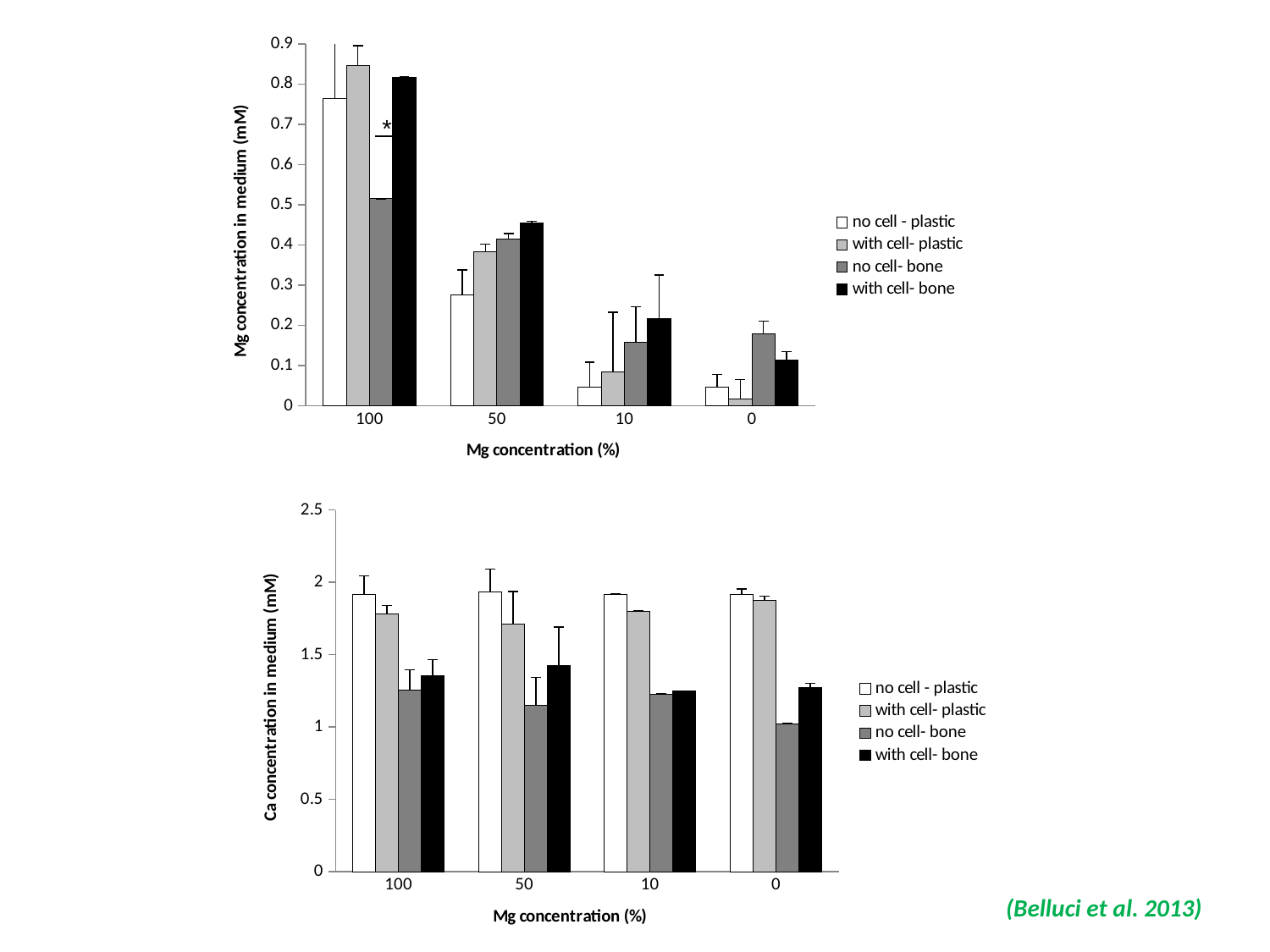
What is the y-axis label of the bottom chart? Ca concentration in medium (mM) In the bottom chart (Ca concentration in medium), at 10% Mg concentration, which is larger: 'no cell - plastic' or 'no cell- bone'? no cell - plastic In the bottom chart (Ca concentration in medium), which series has the lowest value at 0% Mg concentration? no cell- bone In the top chart (Mg concentration in medium), at 100% Mg concentration, which is larger: 'no cell- bone' or 'with cell- bone'? with cell- bone In the top chart (Mg concentration in medium), how many series does the legend list? 4 In the top chart (Mg concentration in medium), how many Mg concentration categories are shown on the x axis? 4 In the top chart (Mg concentration in medium), is the value for 'no cell- bone' at 100% Mg concentration greater or less than 0.6? less In the top chart (Mg concentration in medium), do the values for 'with cell- plastic' rise or fall moving from 100 to 0 along the x axis? fall What kind of chart is the top chart (Mg concentration in medium)? bar chart In the top chart (Mg concentration in medium), which series has the lowest value at 50% Mg concentration? no cell - plastic In the top chart (Mg concentration in medium), is the value for 'no cell - plastic' at 100% Mg concentration greater or less than 0.5? greater In the bottom chart (Ca concentration in medium), is the value for 'no cell- bone' at 0% Mg concentration greater or less than 1.5? less